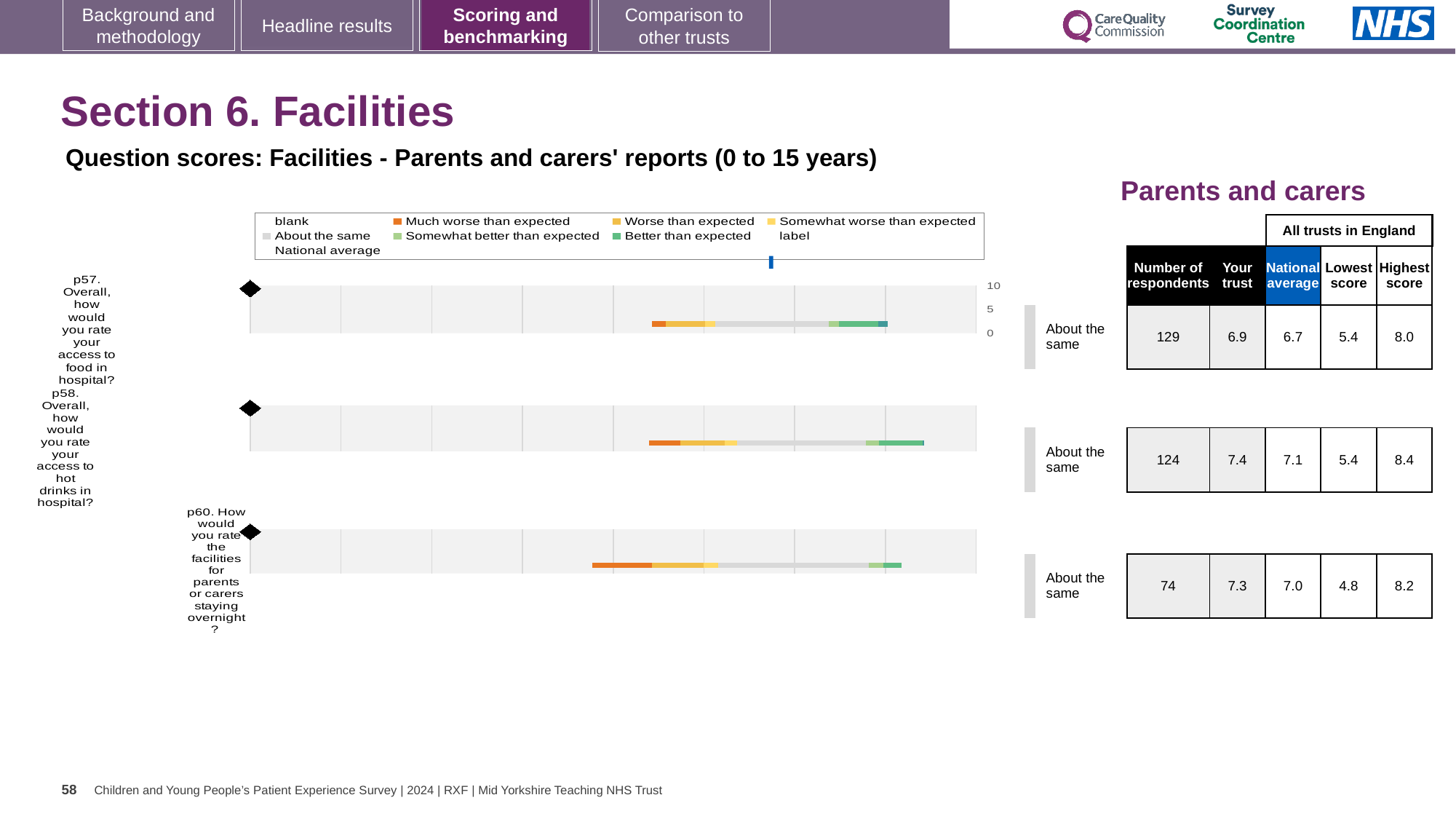
Which question has the lowest number of respondents? p60 What is the difference between the 'Your trust' score and the national average for p57? 0.2 What is the national average score for p58 (access to hot drinks in hospital)? 7.1 How many respondents answered p60 (facilities for parents or carers staying overnight)? 74 What is the highest score across all trusts in England for p58? 8.4 What is the difference between the highest and lowest scores for p60? 3.4 What benchmark category is shown for p60 (facilities for parents or carers staying overnight)? About the same For p58, which is larger: the 'Your trust' score or the national average? Your trust What is the 'Your trust' score for p57 (access to food in hospital)? 6.9 How many questions (chart rows) are plotted on this slide? 3 What kind of chart is used to show the question scores on this slide? bar chart Which question has the highest 'Your trust' score? p58